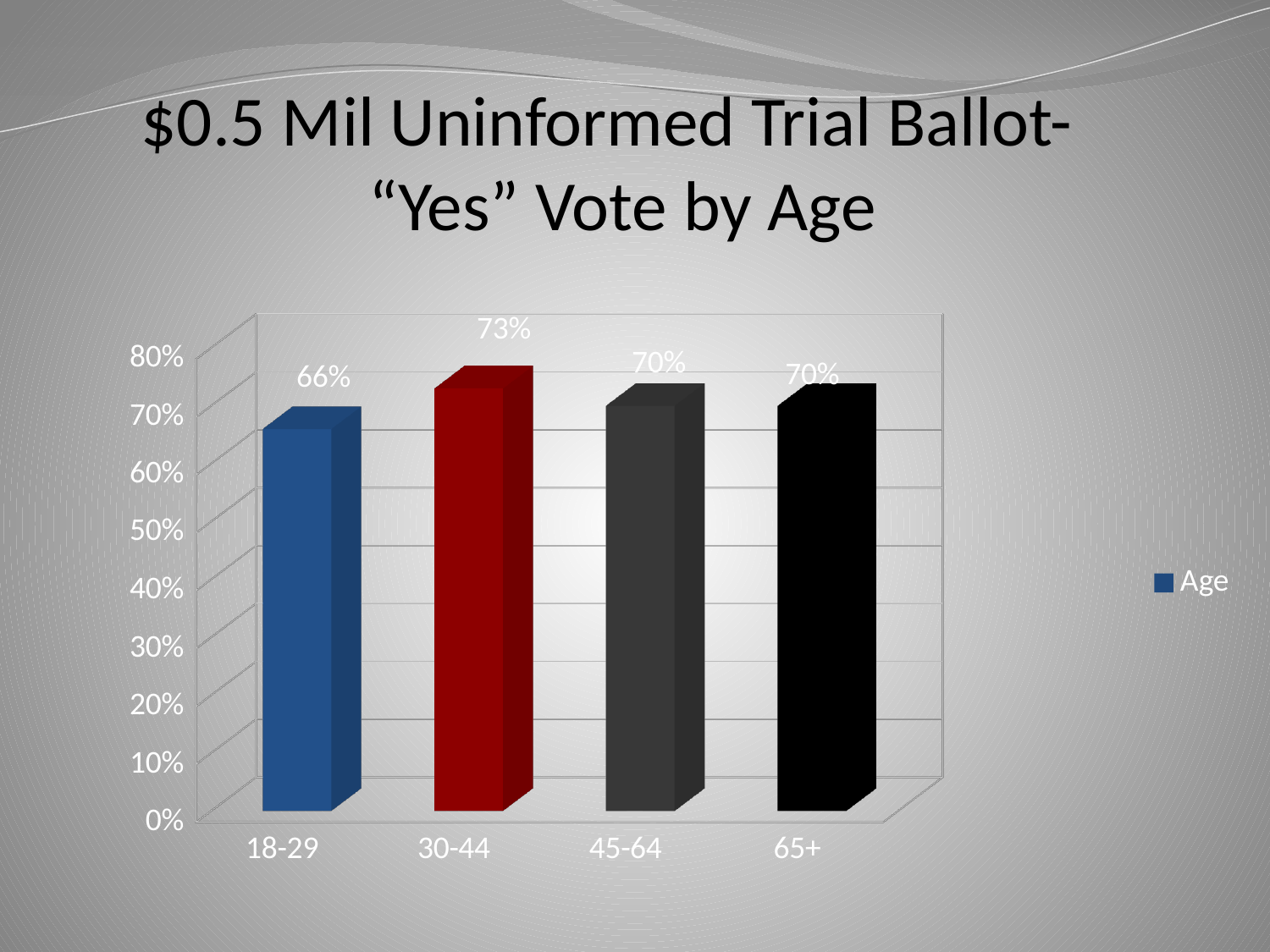
What is the "Yes" vote percentage for the 65+ age group? 70% Is the value for the 30-44 age group greater or less than 70%? greater What kind of chart is shown on the slide? Bar chart What is the "Yes" vote percentage for the 30-44 age group? 73% What is the difference in "Yes" vote percentage between the 30-44 and 18-29 age groups? 7% Which age group has the lowest "Yes" vote percentage? 18-29 What is the "Yes" vote percentage for the 18-29 age group? 66% How many age groups are shown on the chart? 4 Which age group has a higher "Yes" vote percentage, 18-29 or 45-64? 45-64 Which age group has the highest "Yes" vote percentage? 30-44 What is the "Yes" vote percentage for the 45-64 age group? 70% What series name is listed in the chart legend? Age